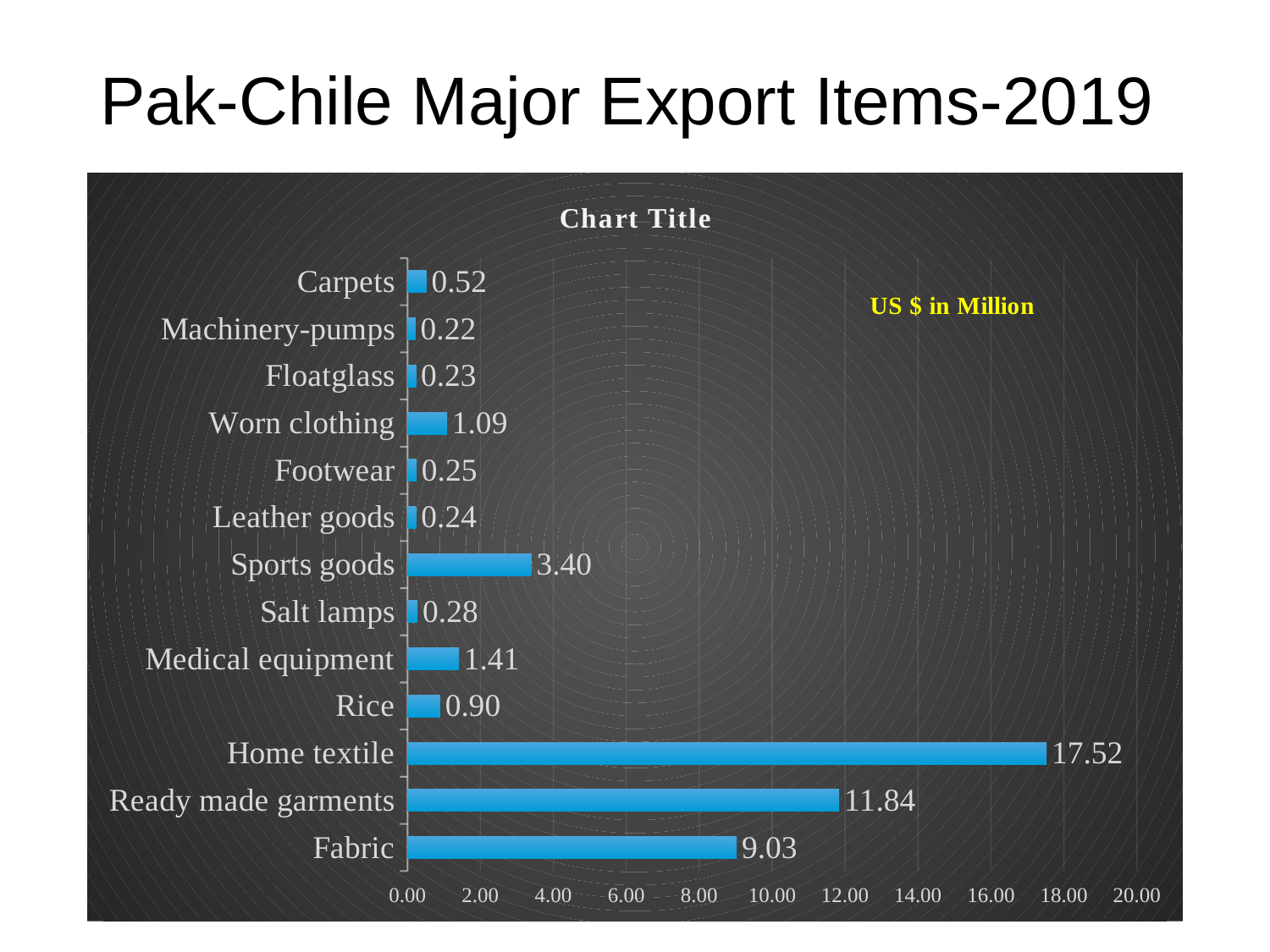
What is the value for Medical equipment? 1.41 What is the value for Sports goods? 3.40 What is the value for Home textile? 17.52 What is the difference between the values for Fabric and Sports goods? 5.63 Which is larger, the value for Fabric or the value for Sports goods? Fabric Which export item has the highest value? Home textile What is the difference between the values for Home textile and Ready made garments? 5.68 Is the value for Ready made garments greater or less than 10.00? greater Which export item has the lowest value? Machinery-pumps What kind of chart is shown on the slide? Bar chart What unit is stated for the values in the chart? US $ in Million How many export items are shown in the chart? 13